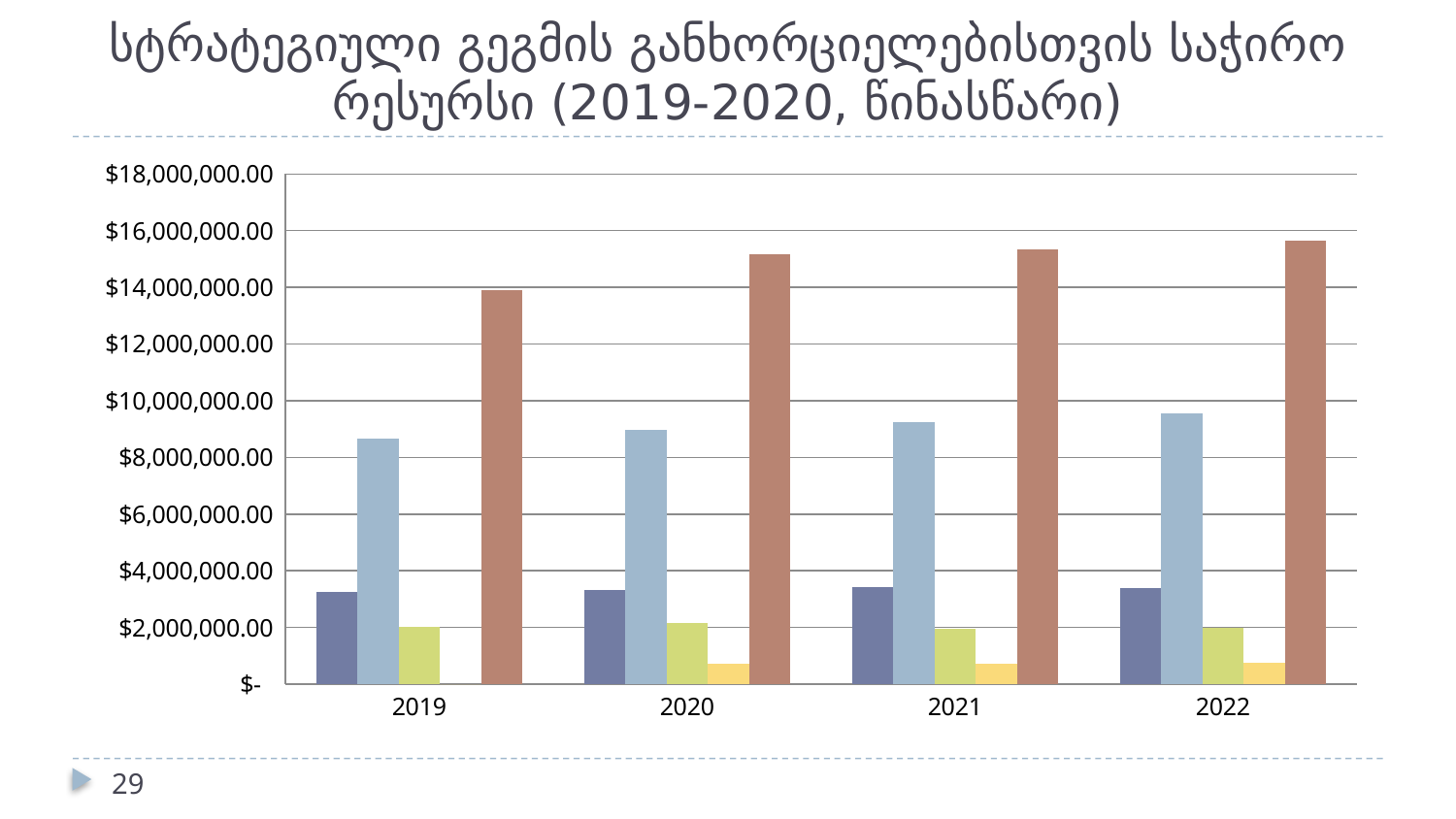
Is the value of the brown bar for 2022 greater or less than $14,000,000.00? greater Is the value of the brown bar for 2019 greater or less than $12,000,000.00? greater Is the value of the light blue bar for 2019 greater or less than $10,000,000.00? less In 2020, which is larger: the brown bar or the light blue bar? the brown bar How many years (categories) are shown on the x axis of the chart? 4 In which year is the brown bar the shortest? 2019 Do the light blue bars rise or fall from 2019 to 2022? rise In which year is the brown bar the tallest? 2022 Do the brown bars rise or fall from 2019 to 2022? rise What kind of chart is shown on the slide? bar chart